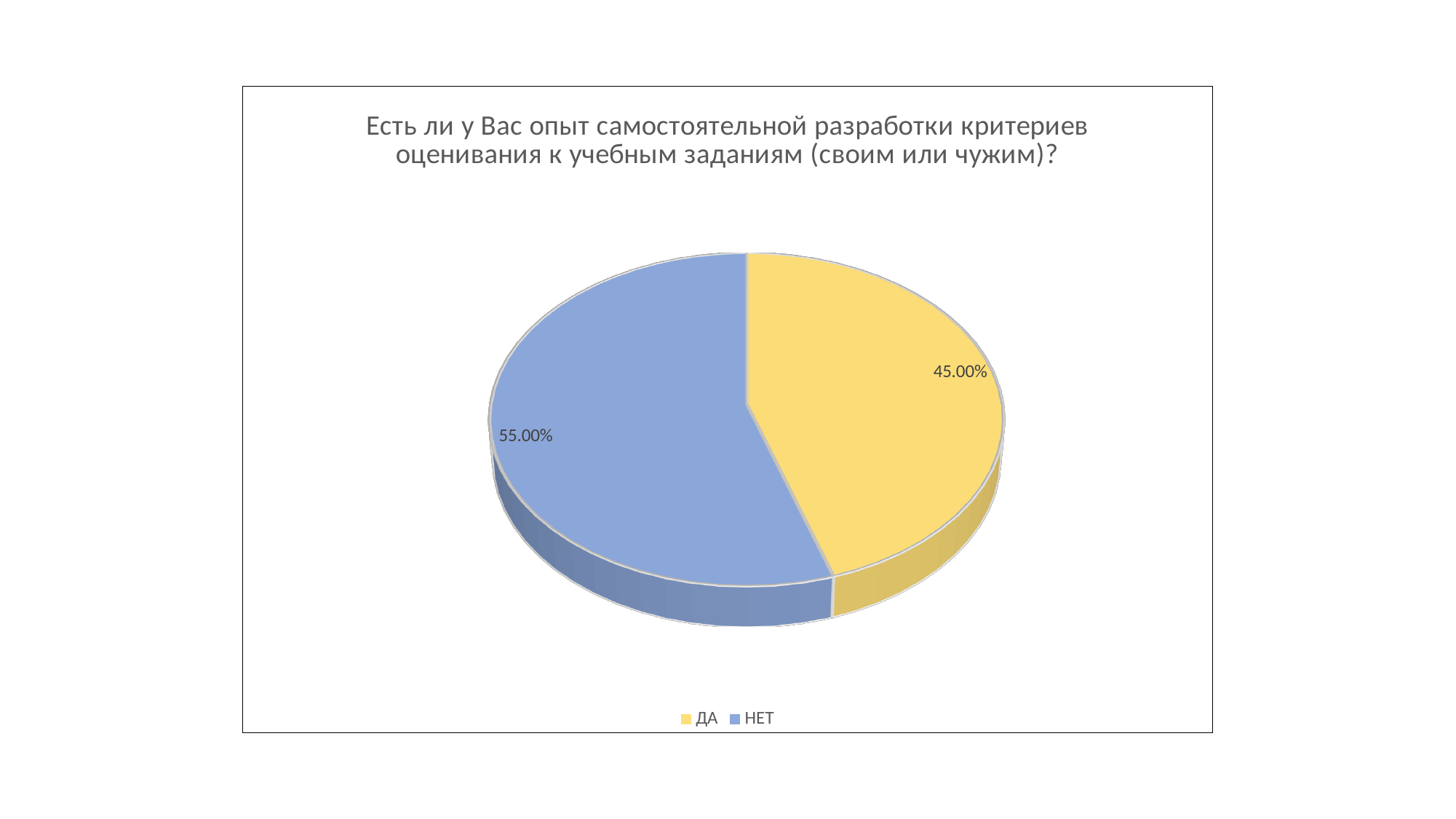
What kind of chart is shown on the slide? Pie chart What share of the pie does the ДА slice represent? 45.00% How many entries does the legend list? 2 What is the difference between the НЕТ and ДА percentages? 10.00% Which is larger, the share for ДА or the share for НЕТ? НЕТ How many slices does the pie chart have? 2 Which category has the smallest slice of the pie? ДА Which category has the largest slice of the pie? НЕТ What is the title of the chart? Есть ли у Вас опыт самостоятельной разработки критериев оценивания к учебным заданиям (своим или чужим)? What percentage is shown for НЕТ? 55.00% What colour is the ДА slice? Yellow What percentage is shown for ДА? 45.00%